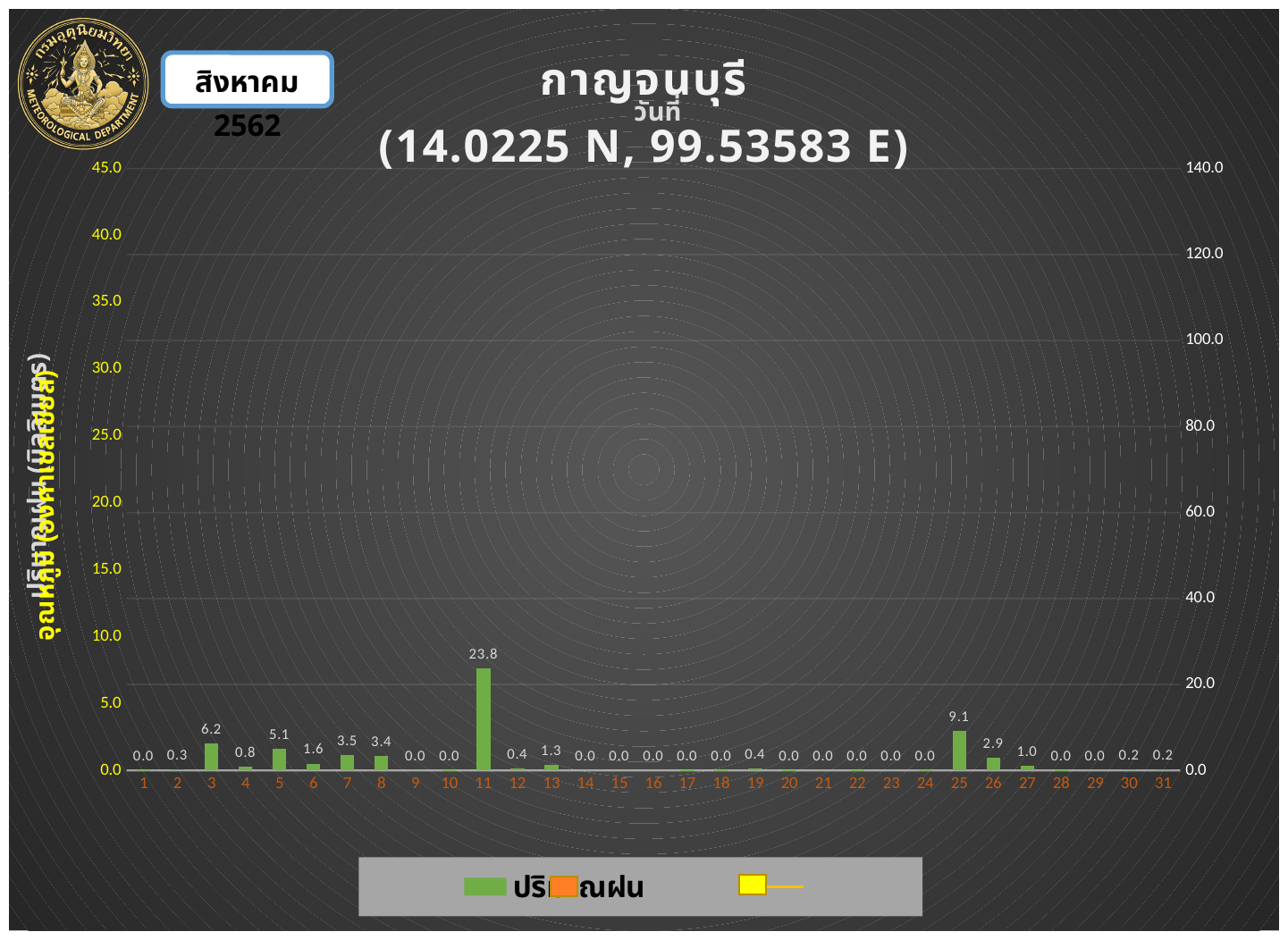
What is the difference between the rainfall values for day 3 and day 5? 1.1 What is the rainfall value for day 11? 23.8 What is the rainfall value for day 3? 6.2 What is the rainfall value for day 25? 9.1 How many days are shown on the x axis? 31 What is the difference between the rainfall values for day 11 and day 25? 14.7 Which day has the highest rainfall value? 11 Which is larger, the rainfall value for day 7 or for day 8? day 7 What kind of chart is shown on the slide? bar chart What coordinates are given in the chart title? 14.0225 N, 99.53583 E What is the rainfall value for day 26? 2.9 Is the rainfall value for day 11 greater or less than 20.0 on the right axis? greater